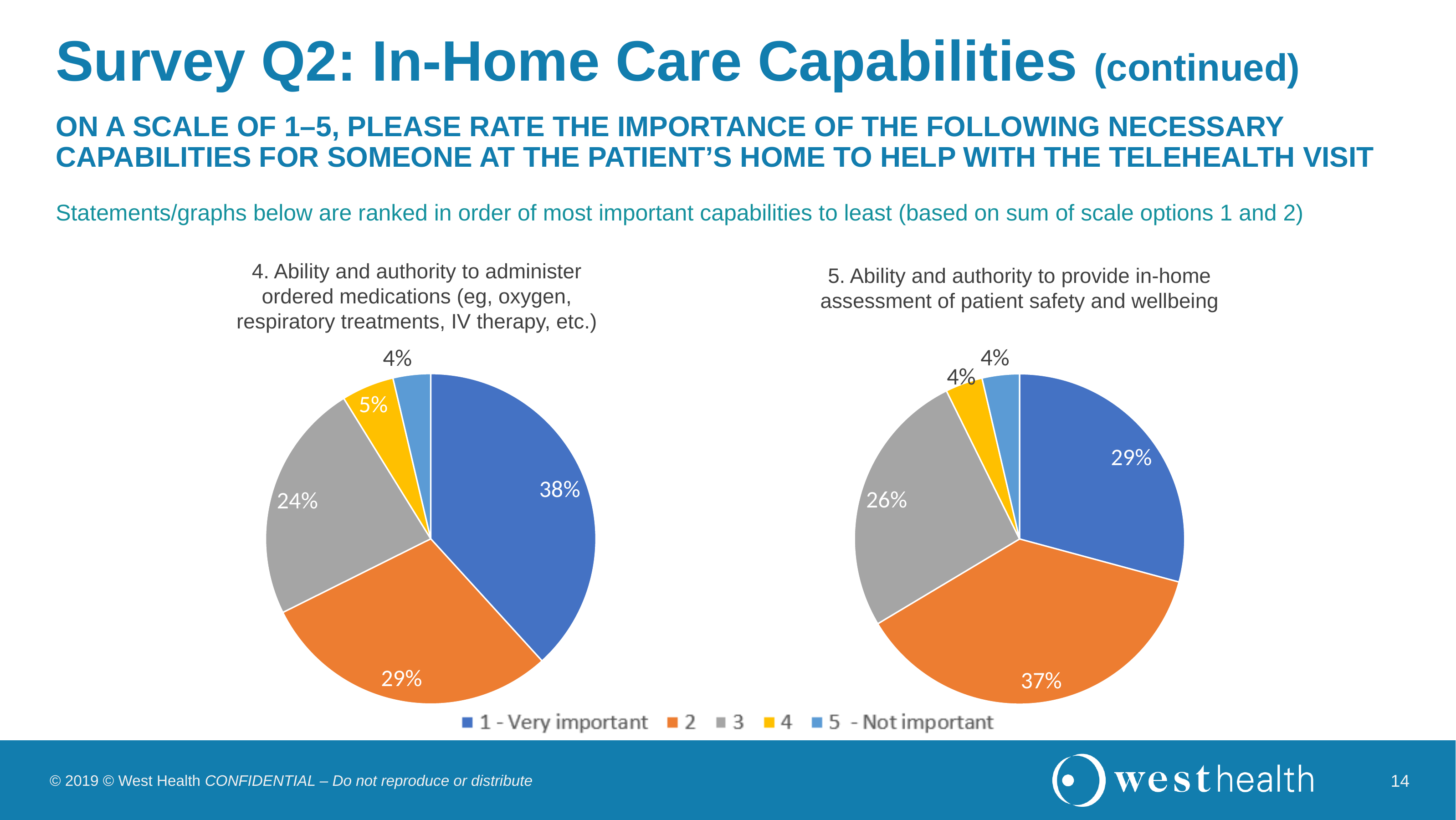
In the right pie chart (5. Ability and authority to provide in-home assessment of patient safety and wellbeing), what share is rated 1 - Very important? 29% In the left pie chart (4. Ability and authority to administer ordered medications), which rating has the largest slice? 1 - Very important In the right pie chart (5. Ability and authority to provide in-home assessment of patient safety and wellbeing), which rating has the largest slice? 2 In the left pie chart (4. Ability and authority to administer ordered medications), what is the difference between the share rated 1 - Very important and the share rated 2? 9% How many entries does the shared legend list? 5 How many slices does the left pie chart (4. Ability and authority to administer ordered medications) have? 5 What type of chart is used for the two charts on the slide? Pie chart In the left pie chart (4. Ability and authority to administer ordered medications), what share is rated 1 - Very important? 38% In the right pie chart (5. Ability and authority to provide in-home assessment of patient safety and wellbeing), what share is rated 2? 37% In the left pie chart (4. Ability and authority to administer ordered medications), what share is rated 3? 24% In the left pie chart (4. Ability and authority to administer ordered medications), which rating has the smallest slice? 5 - Not important In the right pie chart (5. Ability and authority to provide in-home assessment of patient safety and wellbeing), which is larger: the share rated 2 or the share rated 3? 2